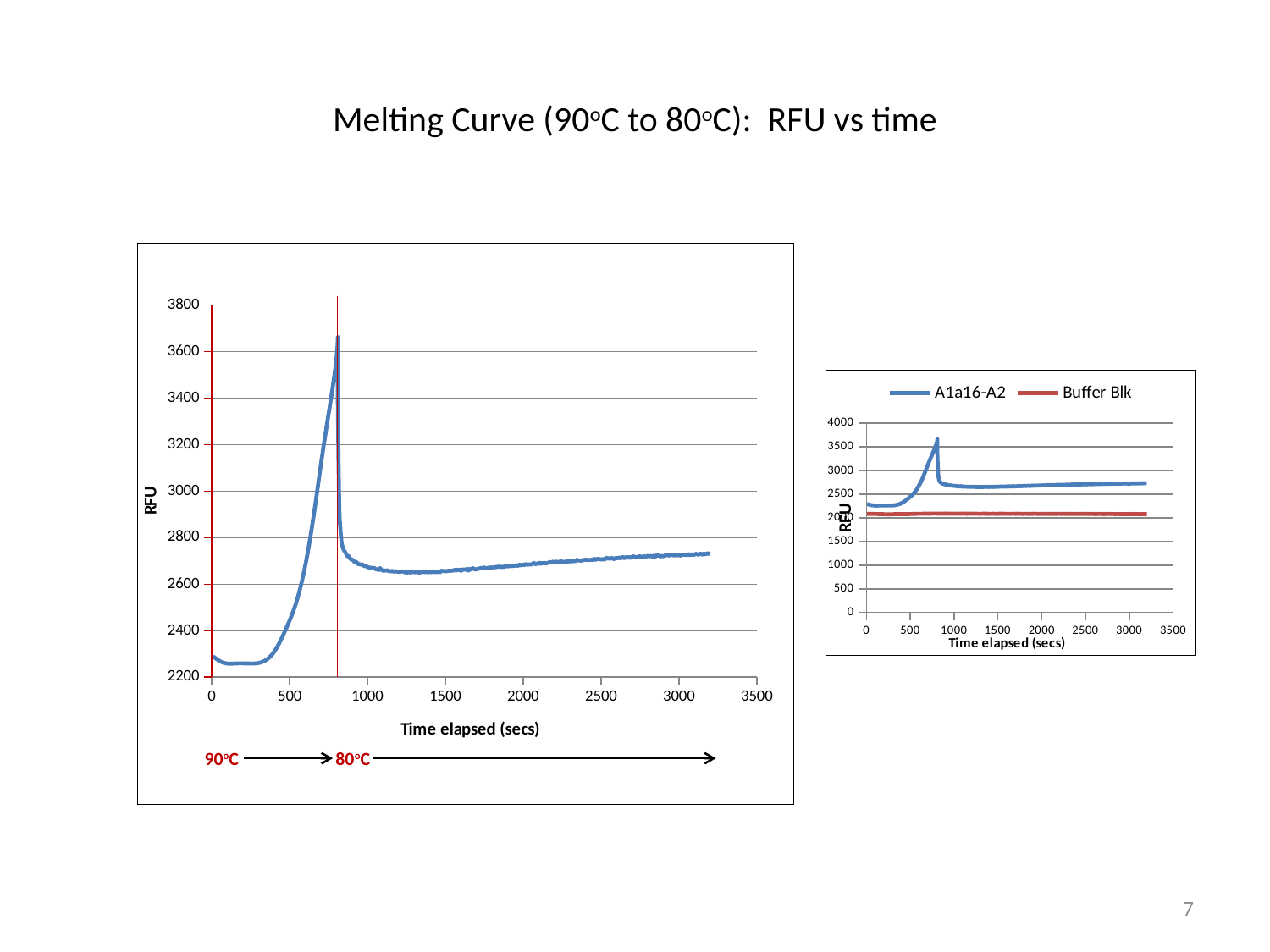
In the smaller chart on the right, what are the two series named in the legend? A1a16-A2 and Buffer Blk In the large chart on the left, is the RFU value at 3000 seconds greater or less than 2800? less In the large chart on the left, what is the title of the x axis? Time elapsed (secs) What kind of chart is the large chart on the left of the slide? line chart In the large chart on the left, is the peak RFU value greater or less than 3400? greater In the large chart on the left, does the RFU value rise or fall between 0 and about 800 seconds? rise In the smaller chart on the right, which series has the lower values throughout? Buffer Blk In the smaller chart on the right, which series has the larger value at 3000 seconds, A1a16-A2 or Buffer Blk? A1a16-A2 In the smaller chart on the right, is the Buffer Blk value greater or less than 2500? less How many series does the legend of the smaller chart on the right list? 2